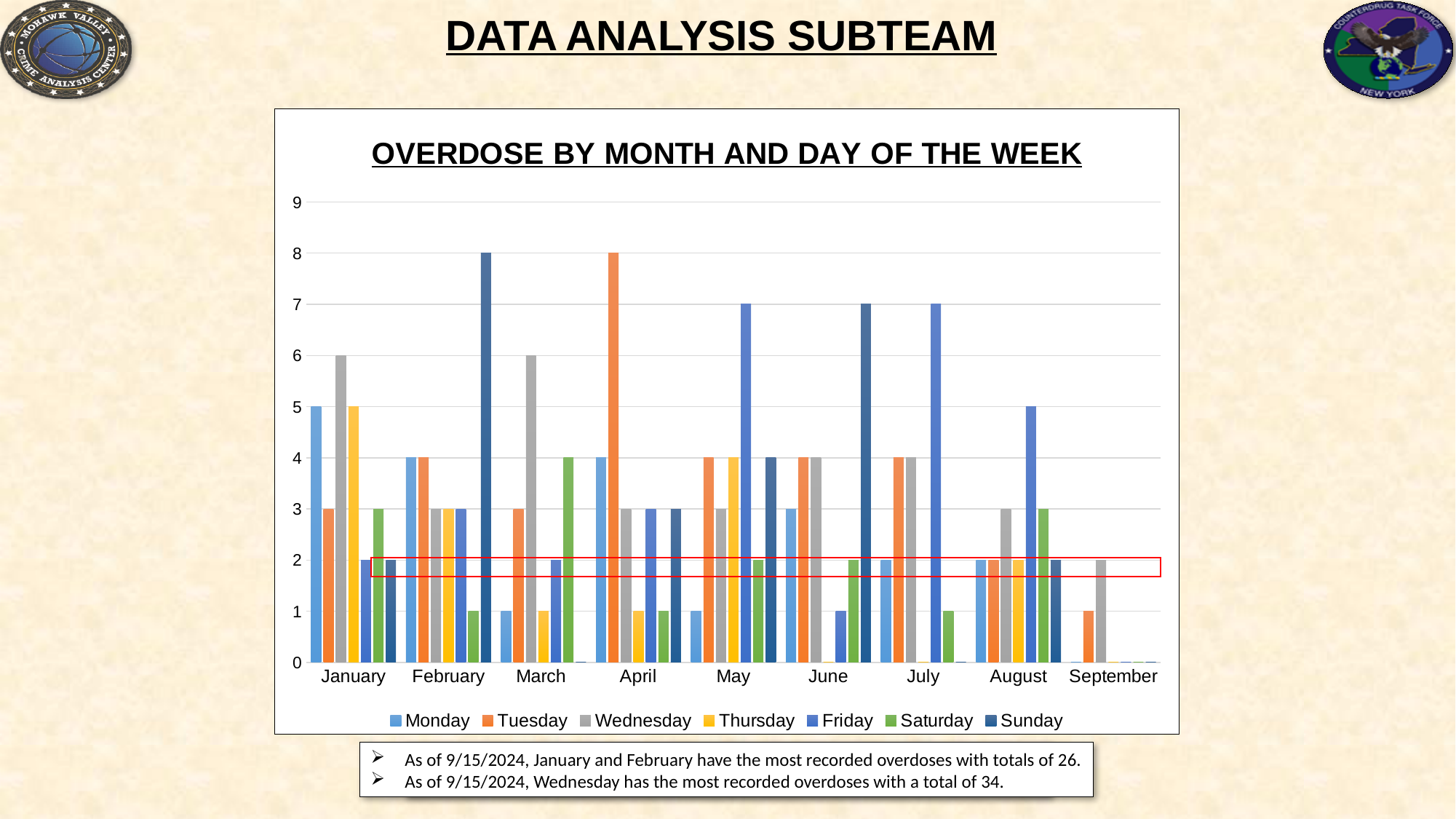
How many series does the legend list? 7 How many months are shown on the x axis? 9 Which day of the week has the highest value in March? Wednesday What is the title of the chart? OVERDOSE BY MONTH AND DAY OF THE WEEK Is the Sunday value in June greater or less than 5? greater Which is larger, the Monday value in January or the Monday value in February? January What is the difference between the Friday value in July and the Friday value in August? 2 What is the value for Wednesday in January? 6 What is the value for Sunday in February? 8 Which day of the week has the highest value in May? Friday What is the value for Tuesday in April? 8 What kind of chart is shown on the slide? Bar chart